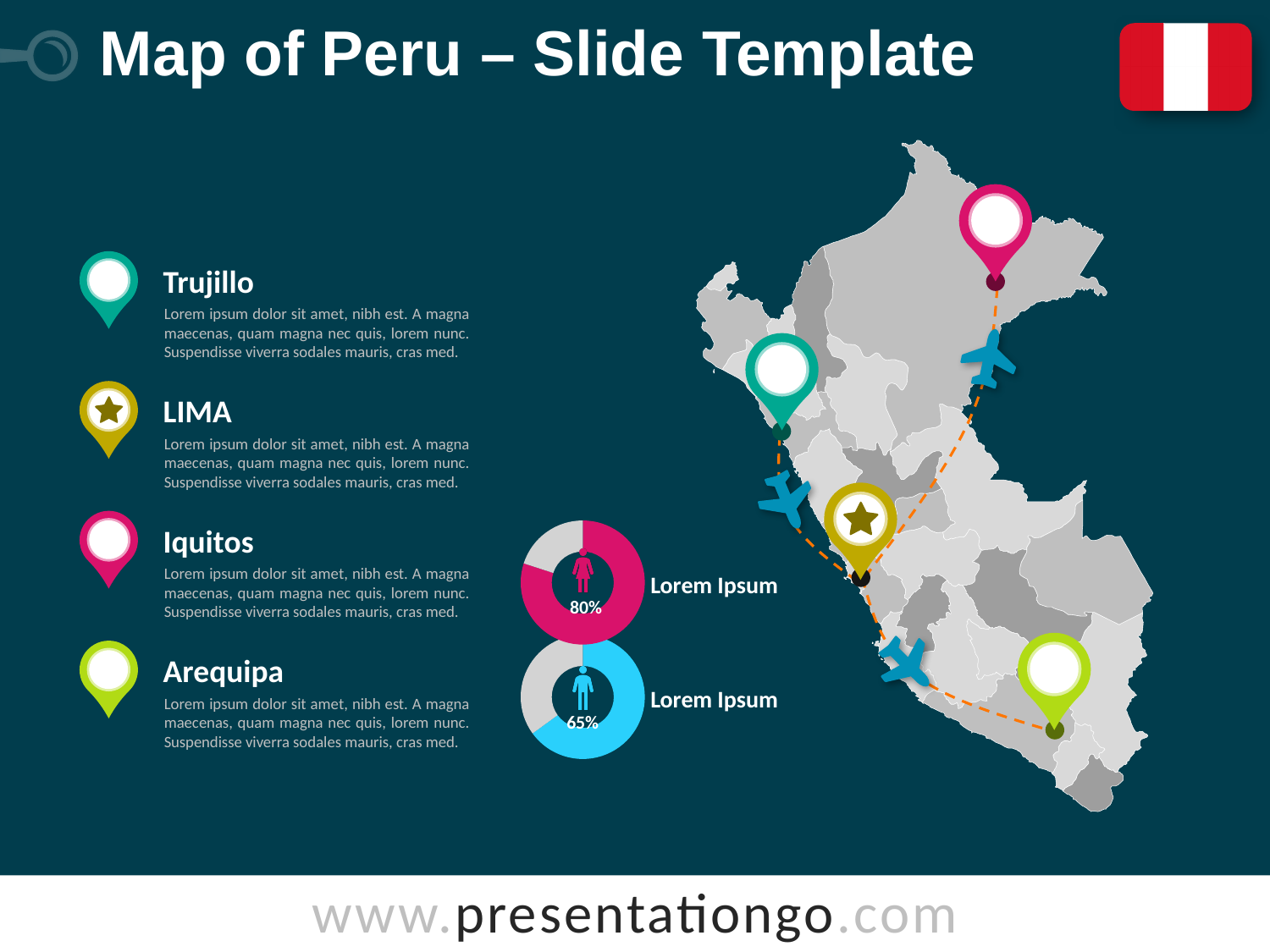
Which donut chart shows the lowest percentage? the bottom (blue) donut chart How many donut charts are on the slide? 2 What text label is placed to the right of each donut chart? Lorem Ipsum What share of the top donut chart is filled in pink? 80% Which of the two donut charts shows the larger value, the pink one or the blue one? the pink one What kind of chart is used to display the 80% and 65% values? donut chart What share of the bottom donut chart is filled in blue? 65% What icon appears in the centre of the pink donut chart? a female figure What percentage is shown on the bottom (blue) donut chart? 65% What percentage is shown on the top (pink) donut chart? 80% What is the difference between the percentage on the pink donut chart and the percentage on the blue donut chart? 15%